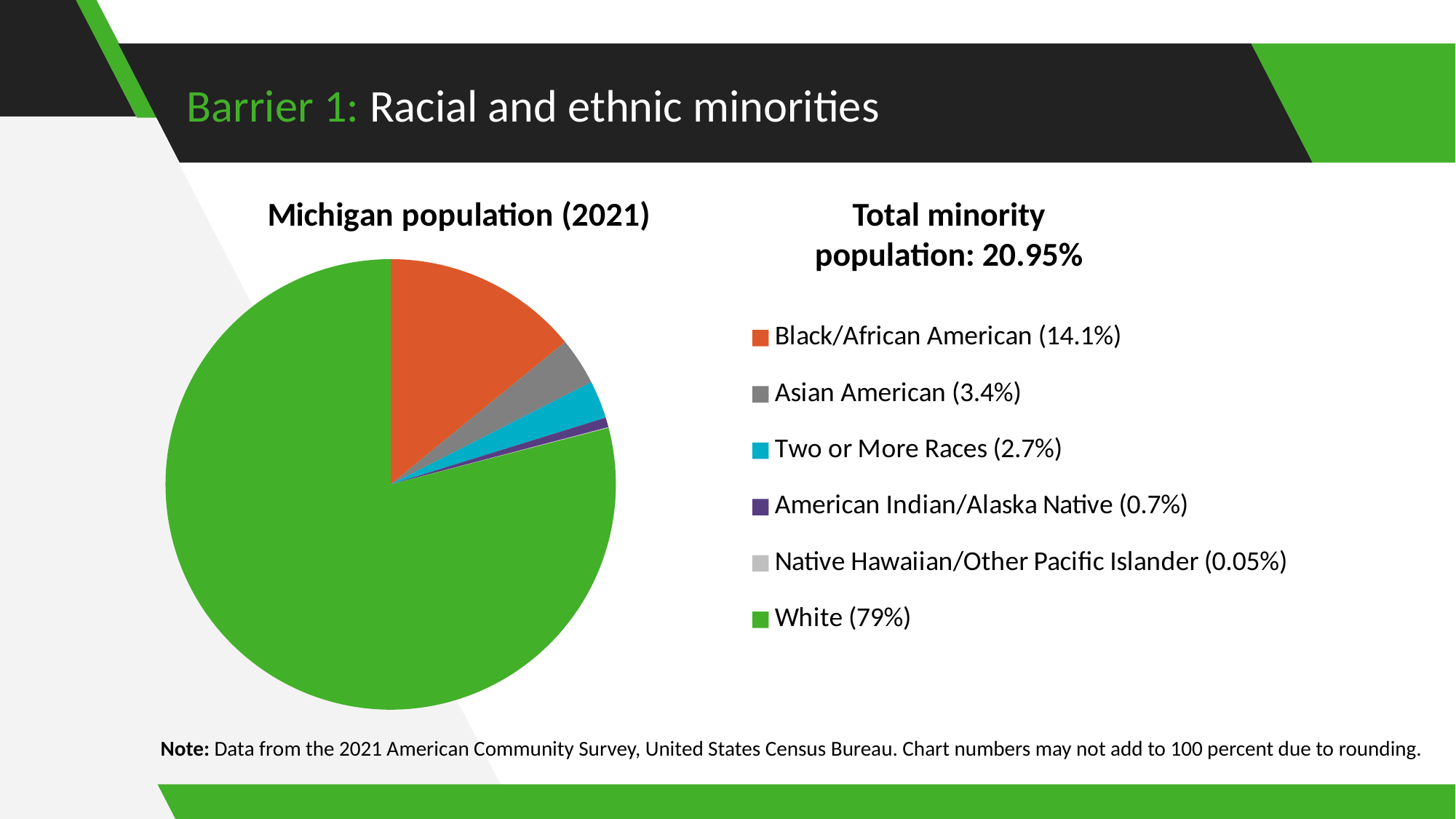
Which is larger, the Asian American share or the Two or More Races share? Asian American What is the difference between the White share and the Black/African American share? 64.9% What is the title of the chart? Michigan population (2021) How many categories does the legend list? 6 What type of chart is shown on the slide? pie chart What percentage of the Michigan population is American Indian/Alaska Native? 0.7% What percentage of the Michigan population is Asian American? 3.4% What percentage of the Michigan population is Two or More Races? 2.7% Which category has the smallest share of the pie? Native Hawaiian/Other Pacific Islander What percentage of the Michigan population is Native Hawaiian/Other Pacific Islander? 0.05% Which category has the largest share of the pie? White What percentage of the Michigan population is Black/African American? 14.1%